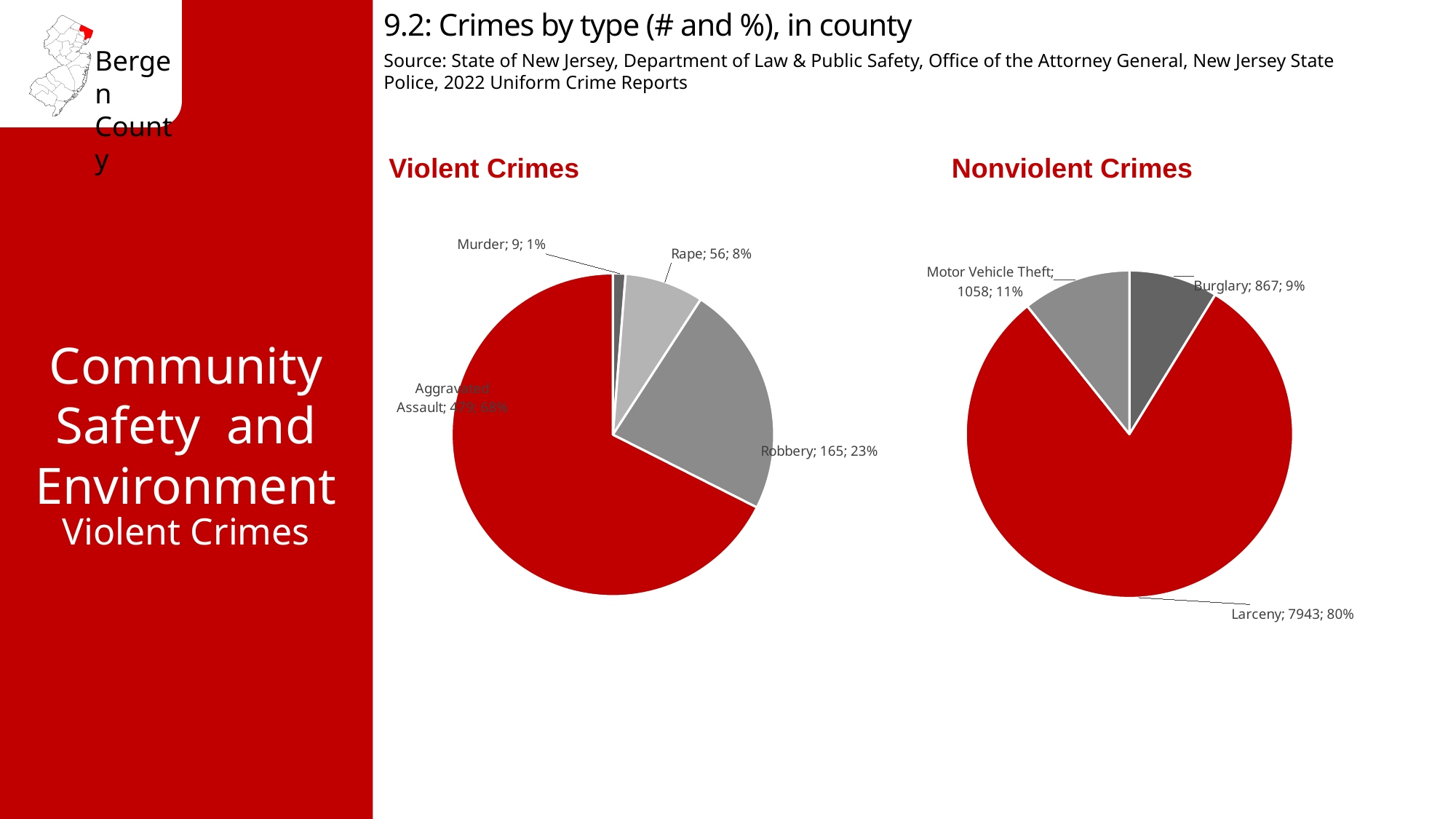
In the Violent Crimes pie chart, which category has the largest slice? Aggravated Assault In the Violent Crimes pie chart, what percentage of violent crimes is rape? 8% In the Violent Crimes pie chart, what is the difference between the number of robberies and the number of rapes? 109 In the Nonviolent Crimes pie chart, how many larcenies are shown? 7943 In the Violent Crimes pie chart, how many murders are shown? 9 In the Nonviolent Crimes pie chart, what is the difference between the number of motor vehicle thefts and burglaries? 191 In the Violent Crimes pie chart, which category has the smallest slice? Murder In the Violent Crimes pie chart, how many robberies are shown? 165 What type of chart is used for Violent Crimes? Pie chart In the Nonviolent Crimes pie chart, what percentage of nonviolent crimes is motor vehicle theft? 11% How many categories does the Nonviolent Crimes pie chart show? 3 In the Nonviolent Crimes pie chart, which is larger, burglary or motor vehicle theft? Motor Vehicle Theft